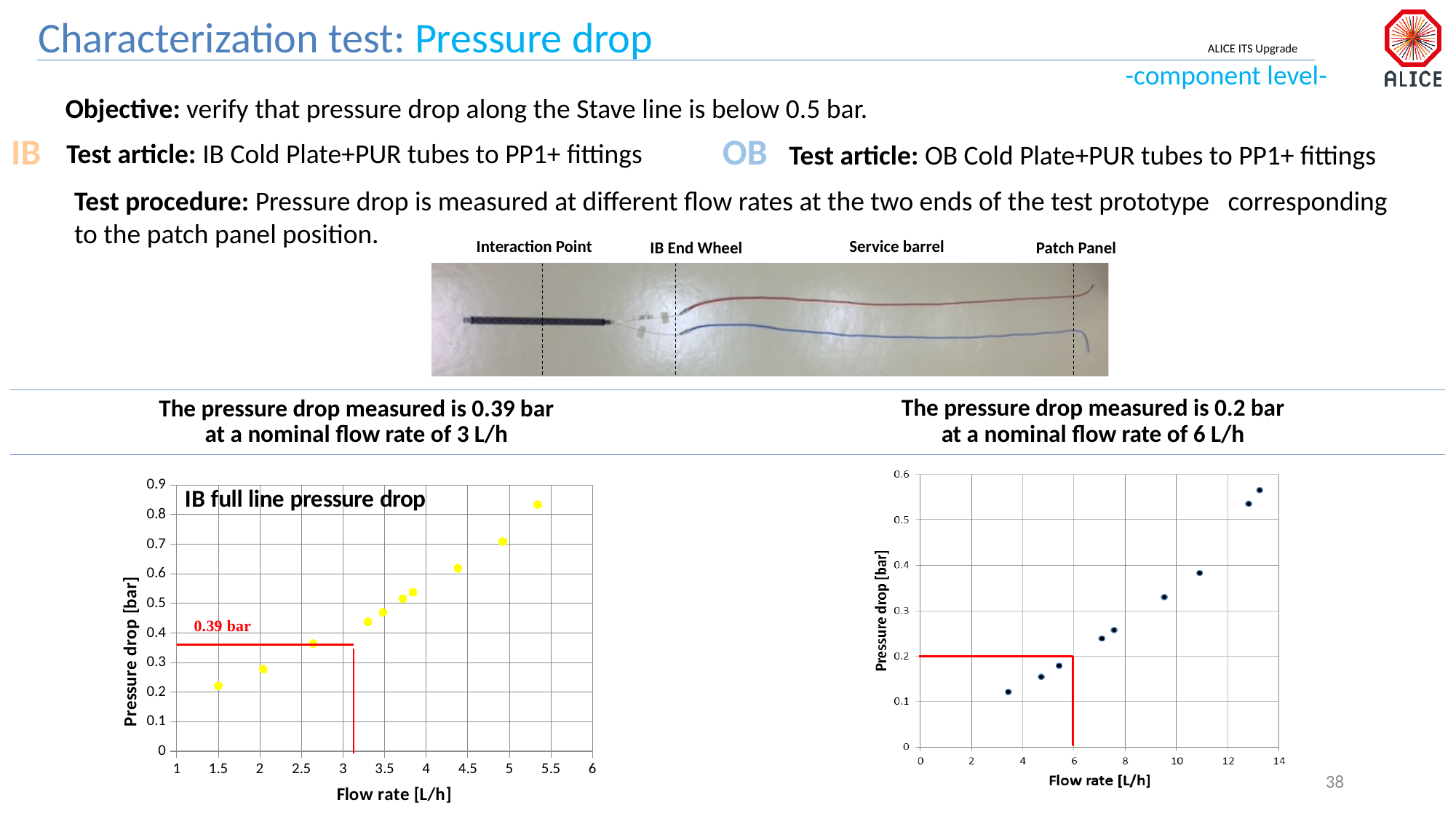
In the left chart 'IB full line pressure drop', does the pressure drop rise or fall as the flow rate increases? rise How many data points are plotted in the left chart 'IB full line pressure drop'? 10 In the left chart 'IB full line pressure drop', is the pressure drop at the highest flow rate (about 5.4 L/h) greater or less than 0.7 bar? greater What is the x-axis label of the left chart 'IB full line pressure drop'? Flow rate [L/h] In the right chart, is the pressure drop at the lowest flow rate (about 3.5 L/h) greater or less than 0.2 bar? less In the left chart 'IB full line pressure drop', is the pressure drop at the lowest flow rate (about 1.5 L/h) greater or less than 0.3 bar? less What is the title of the left chart? IB full line pressure drop What type of chart is the left chart titled 'IB full line pressure drop'? scatter chart What value does the red annotation on the left chart 'IB full line pressure drop' indicate? 0.39 bar In the right chart, does the pressure drop rise or fall as the flow rate increases? rise